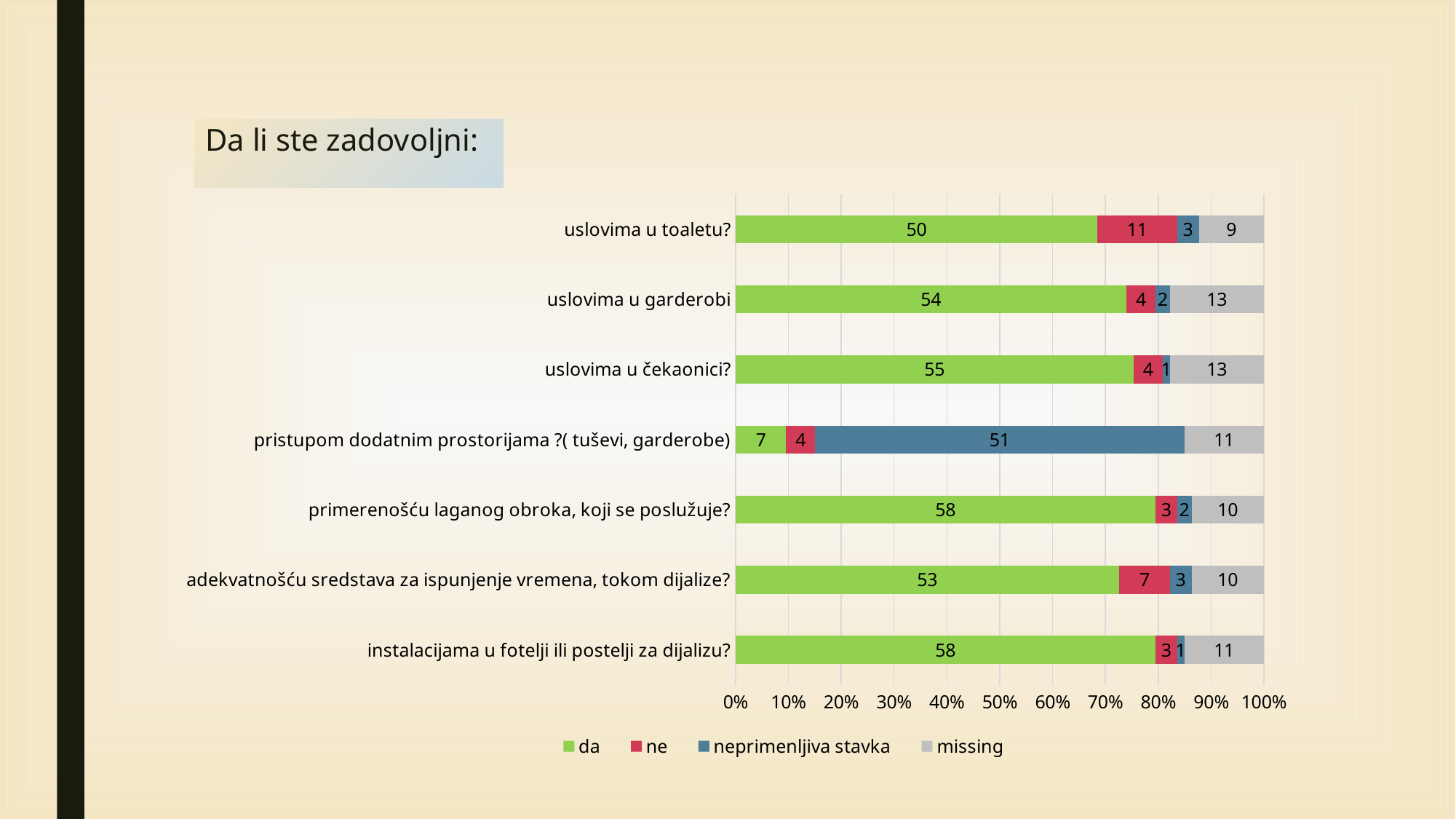
Which category has the lowest 'da' value? pristupom dodatnim prostorijama ?( tuševi, garderobe) What is the total of all segments in the bar for 'primerenošću laganog obroka, koji se poslužuje?'? 73 How many series does the legend list? 4 What is the 'da' value for 'uslovima u toaletu?'? 50 What is the 'missing' value for 'uslovima u garderobi'? 13 Which has a larger 'ne' value: 'uslovima u toaletu?' or 'uslovima u garderobi'? uslovima u toaletu? What is the 'ne' value for 'adekvatnošću sredstava za ispunjenje vremena, tokom dijalize?'? 7 How many categories are shown on the chart? 7 Which category has the highest 'ne' value? uslovima u toaletu? What kind of chart is shown on the slide? stacked bar chart What is the difference between the 'da' values for 'uslovima u čekaonici?' and 'uslovima u toaletu?'? 5 What is the 'neprimenljiva stavka' value for 'pristupom dodatnim prostorijama ?( tuševi, garderobe)'? 51